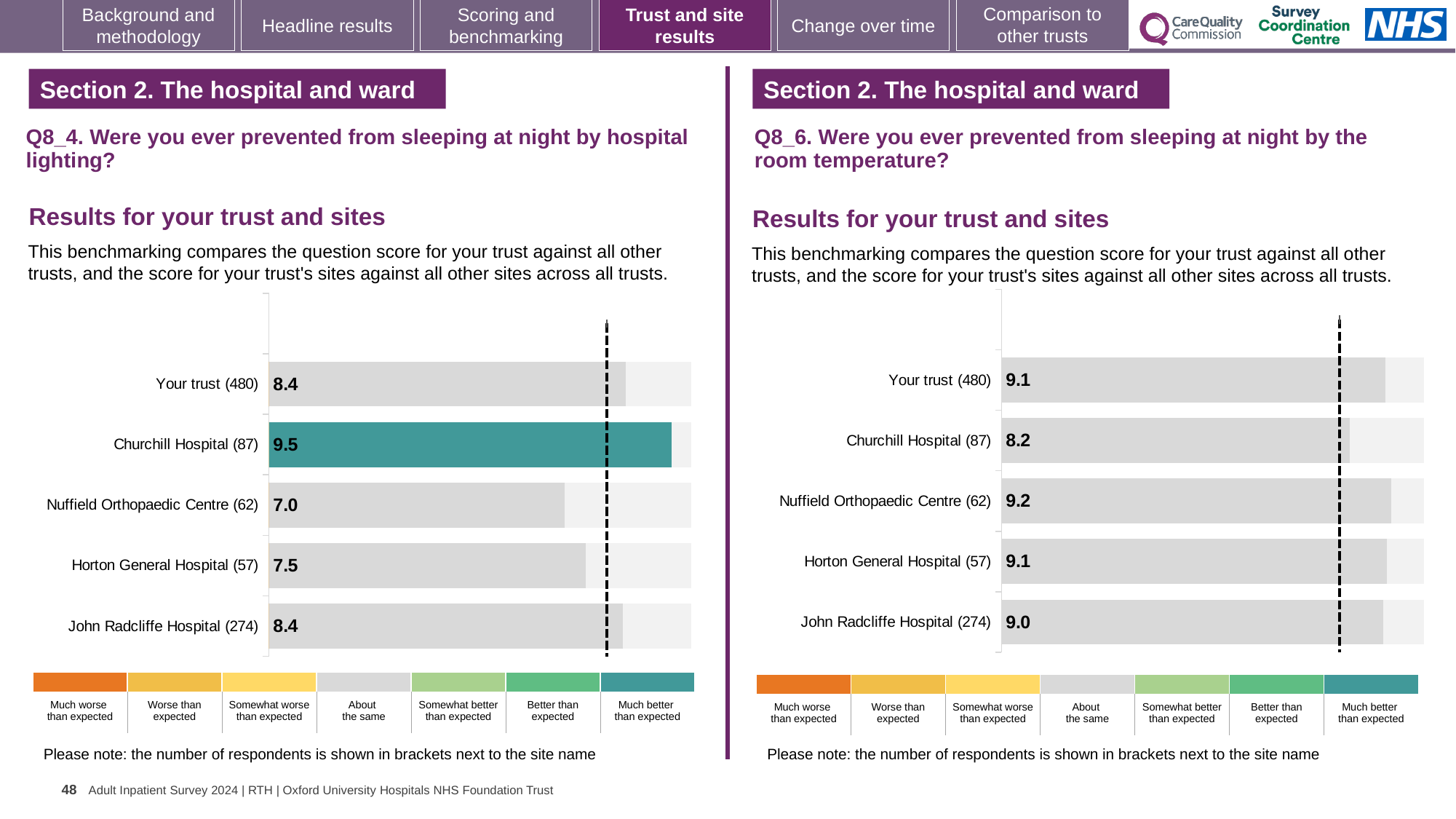
In the Q8_6 chart (room temperature), what is the difference between the Nuffield Orthopaedic Centre score and the Churchill Hospital score? 1.0 In the Q8_4 chart (hospital lighting), which site has the highest score? Churchill Hospital In the Q8_4 chart (hospital lighting), what is the score for Churchill Hospital? 9.5 In the Q8_6 chart (room temperature), which site has the lowest score? Churchill Hospital What type of chart is used in the Q8_4 chart (hospital lighting)? Bar chart In the Q8_6 chart (room temperature), what is the score for Your trust? 9.1 In the Q8_4 chart (hospital lighting), how many bars are plotted? 5 In the Q8_4 chart (hospital lighting), which site has the lowest score? Nuffield Orthopaedic Centre In the Q8_4 chart (hospital lighting), what is the score for Nuffield Orthopaedic Centre? 7.0 In the Q8_4 chart (hospital lighting), what is the difference between the Churchill Hospital score and the Horton General Hospital score? 2.0 In the Q8_6 chart (room temperature), what is the score for John Radcliffe Hospital? 9.0 In the Q8_6 chart (room temperature), which is larger: the score for Nuffield Orthopaedic Centre or the score for Churchill Hospital? Nuffield Orthopaedic Centre